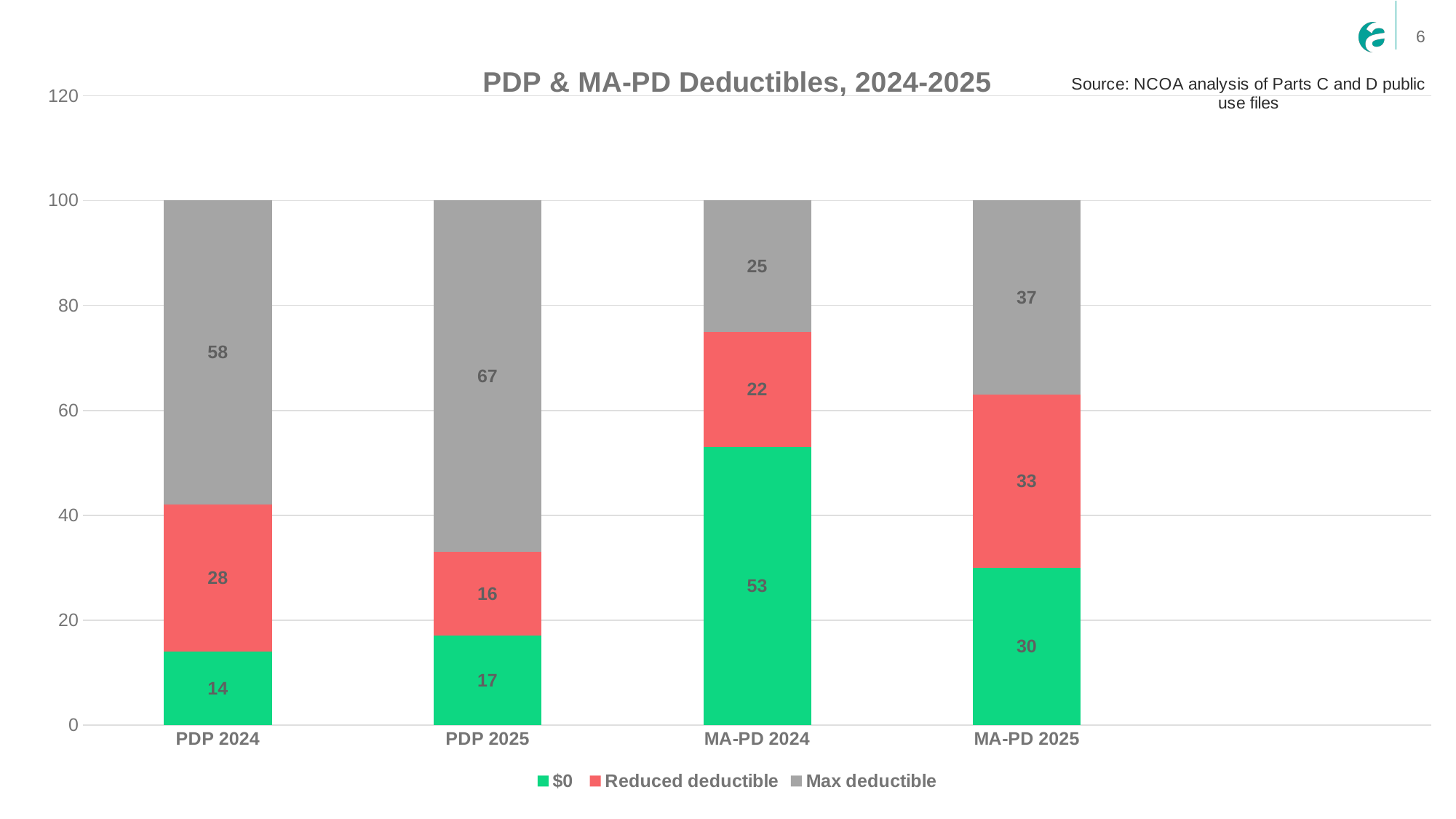
Which category has the highest Max deductible value? PDP 2025 What is the value of the $0 series for MA-PD 2024? 53 How many series does the legend list? 3 What is the title of the chart? PDP & MA-PD Deductibles, 2024-2025 What is the value of the Reduced deductible series for MA-PD 2025? 33 How many categories are shown on the x axis? 4 Which category has the lowest $0 value? PDP 2024 What is the value of the Max deductible series for PDP 2025? 67 What kind of chart is shown on the slide? Stacked bar chart What is the total of the stacked bar for MA-PD 2025? 100 What is the difference between the Max deductible values for PDP 2025 and PDP 2024? 9 Which is larger, the Reduced deductible value for PDP 2024 or for PDP 2025? PDP 2024